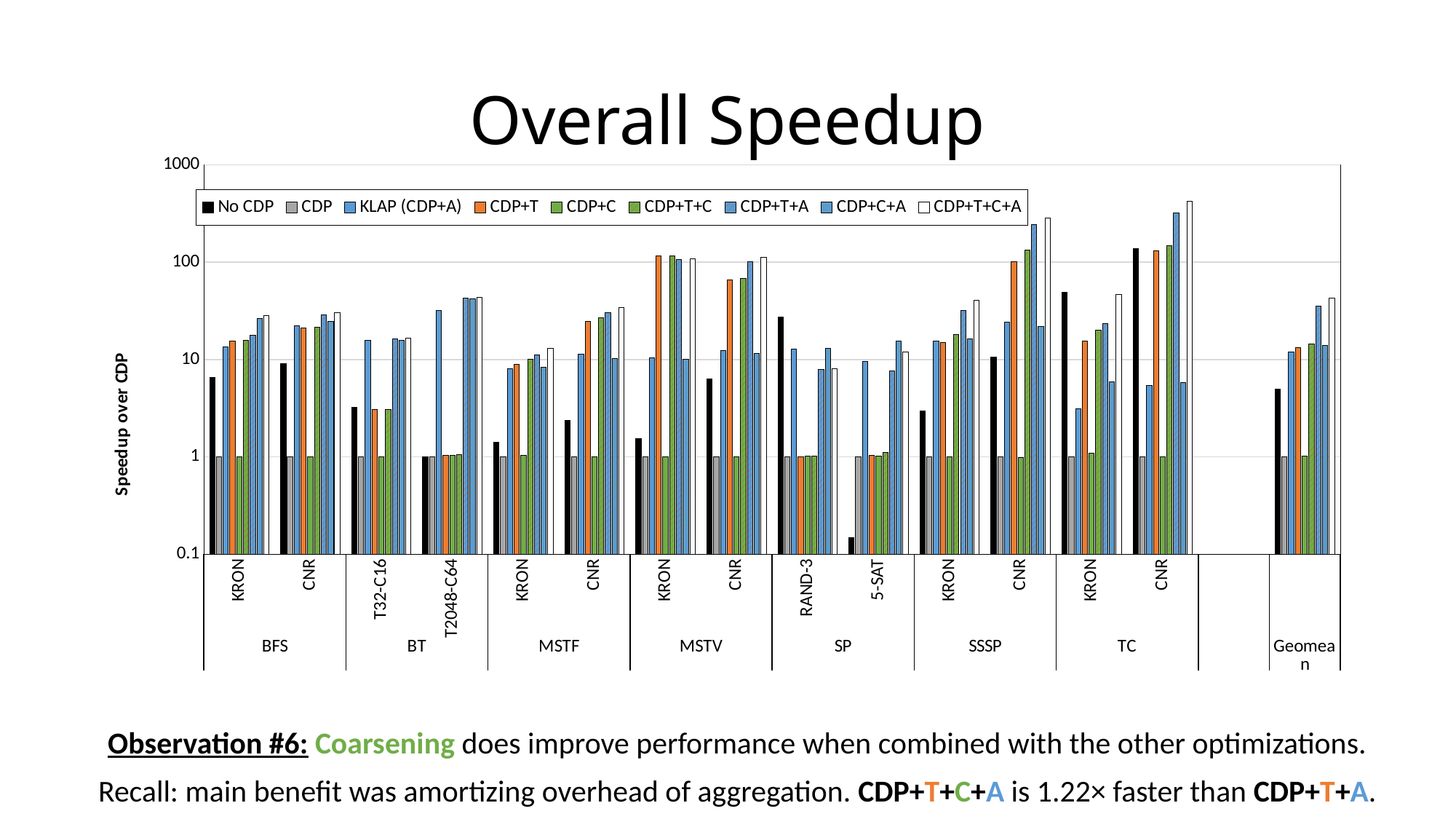
How many series does the legend list? 9 Is the value for CDP+T+C+A in the TC CNR group greater or less than 100? greater How many benchmark groups (including Geomean) are labeled along the x axis? 8 What kind of chart is shown on the slide? bar chart What is the title of the chart? Overall Speedup What is the label on the y axis? Speedup over CDP Is the value for No CDP in the TC KRON group greater or less than 100? less Is the value for CDP+T in the BT T32-C16 group greater or less than 10? less In the TC CNR group, which is larger: CDP+T+C+A or CDP+C+A? CDP+T+C+A What is the value for CDP in the BFS KRON group? 1 In the Geomean group, which is larger: No CDP or CDP+T+C+A? CDP+T+C+A